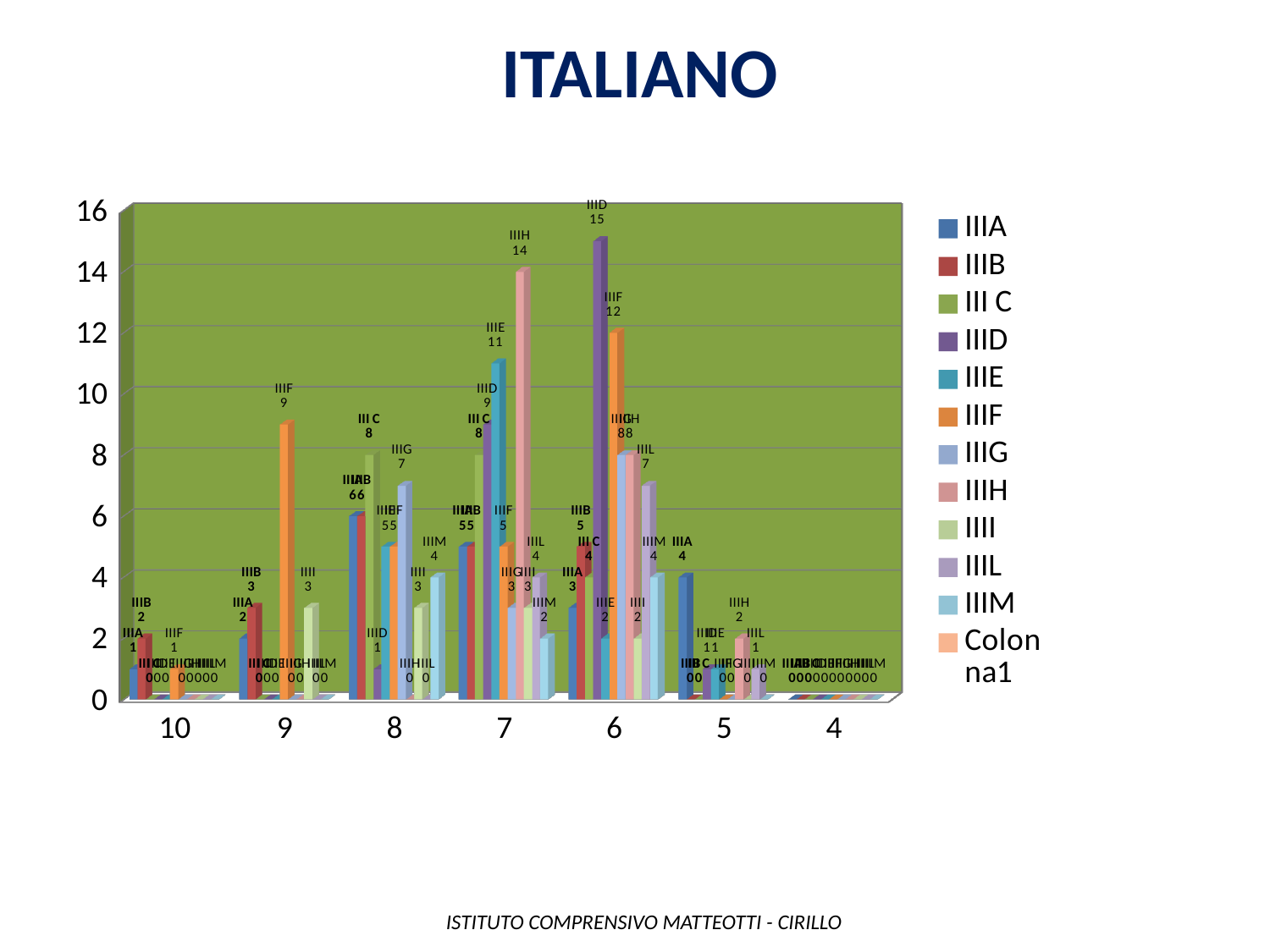
Which series has the highest bar in the whole chart? IIID At grade 7, which is larger: the value for IIIH or the value for IIIE? IIIH How many categories are shown on the x axis? 7 What is the value for IIID at grade 6? 15 How many series does the legend list? 12 What is the value for IIIH at grade 7? 14 Is the value for IIIE at grade 7 greater or less than 10? greater What is the value for IIIF at grade 9? 9 What kind of chart is shown on the slide? bar chart What is the title of the chart? ITALIANO What is the value for IIIF at grade 6? 12 What is the difference between the IIID value and the IIIF value at grade 6? 3